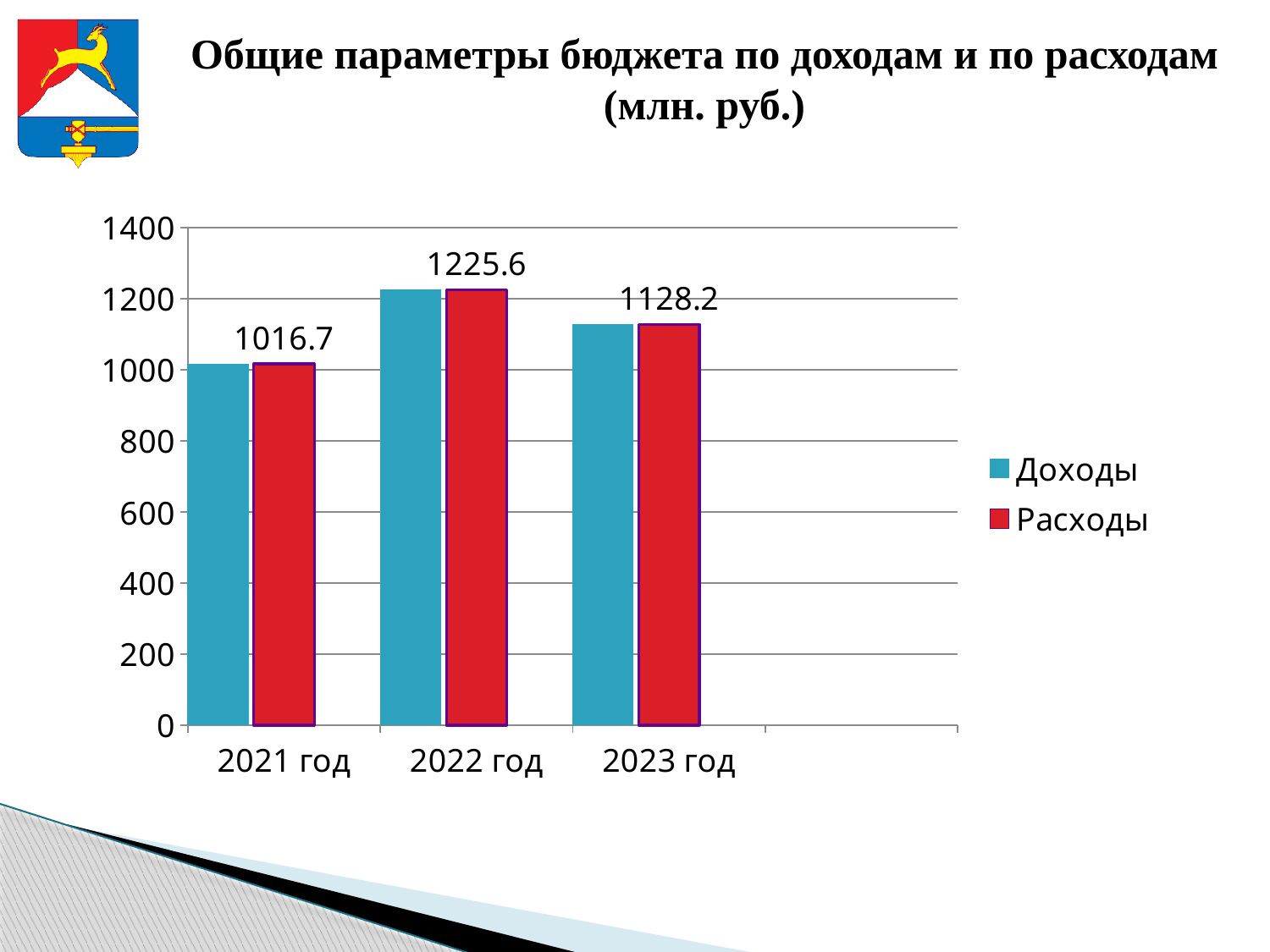
What is the value of Расходы for 2021 год? 1016.7 What is the value of Расходы for 2023 год? 1128.2 Which is larger: Расходы in 2023 год or Расходы in 2021 год? 2023 год What is the difference between Расходы in 2022 год and 2021 год? 208.9 How many series does the legend list? 2 What kind of chart is shown on the slide? bar chart In which year is Расходы the highest? 2022 год Is the value of Доходы for 2022 год greater or less than 1200? greater What is the value of Расходы for 2022 год? 1225.6 In which year is Расходы the lowest? 2021 год How many years are shown on the x axis? 3 What is the difference between Расходы in 2022 год and 2023 год? 97.4